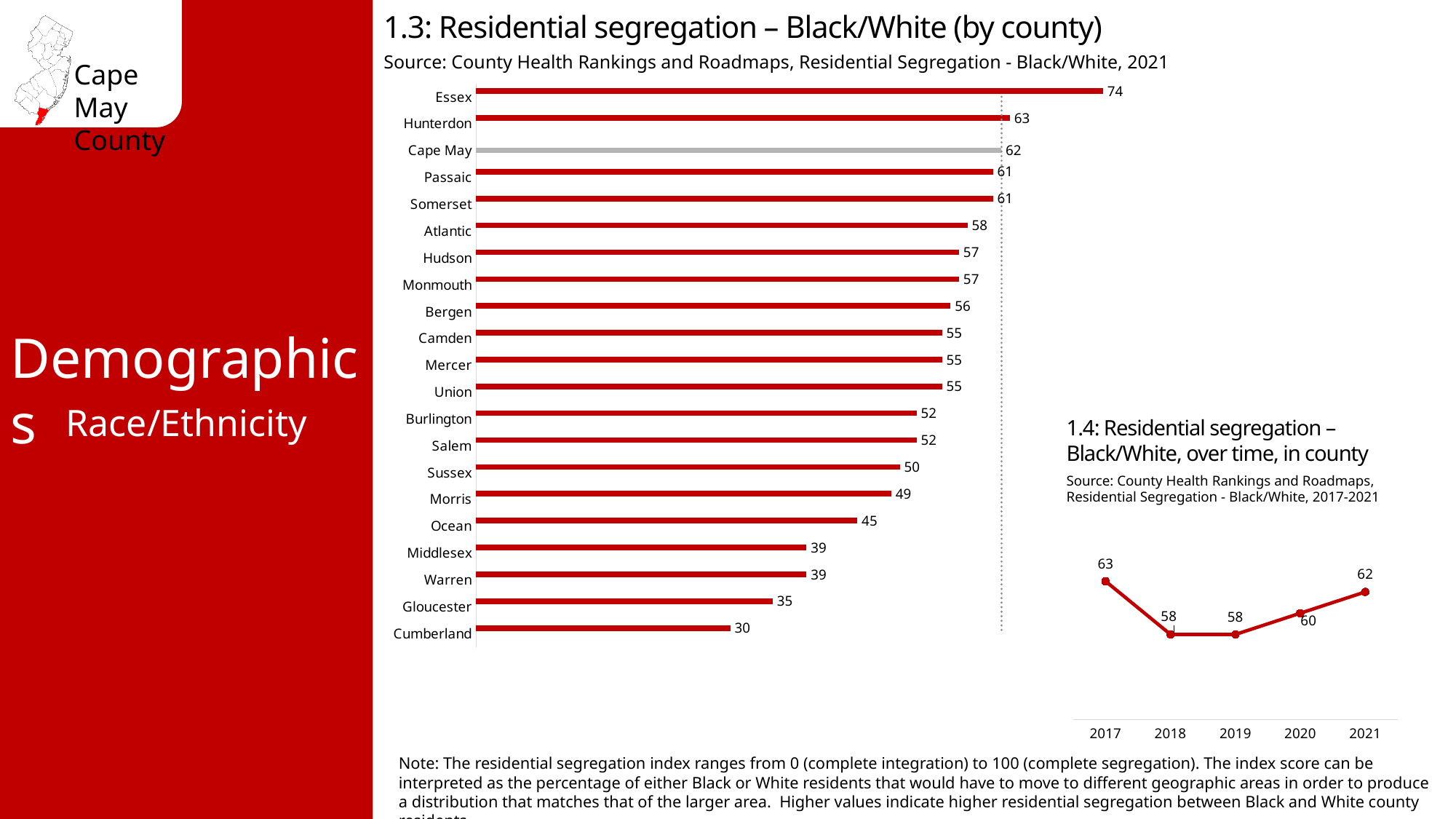
In chart 1.4 (over time, in county), how many years are plotted? 5 In chart 1.3 (by county), how many counties are shown? 21 In chart 1.3 (Residential segregation – Black/White by county), what is the value for Cape May? 62 In chart 1.3 (by county), what is the difference between the values for Essex and Cumberland? 44 In chart 1.4 (over time, in county), which year has the lowest value? 2018 and 2019 What kind of chart is chart 1.3 (Residential segregation – Black/White by county)? Bar chart In chart 1.4 (over time, in county), what is the difference between the 2021 and 2020 values? 2 In chart 1.3 (by county), which has a higher value, Ocean or Middlesex? Ocean In chart 1.3 (by county), which county has the lowest residential segregation index? Cumberland In chart 1.3 (by county), what is the value for Gloucester? 35 In chart 1.3 (by county), which county has the highest residential segregation index? Essex In chart 1.4 (Residential segregation over time, in county), what is the value for 2017? 63